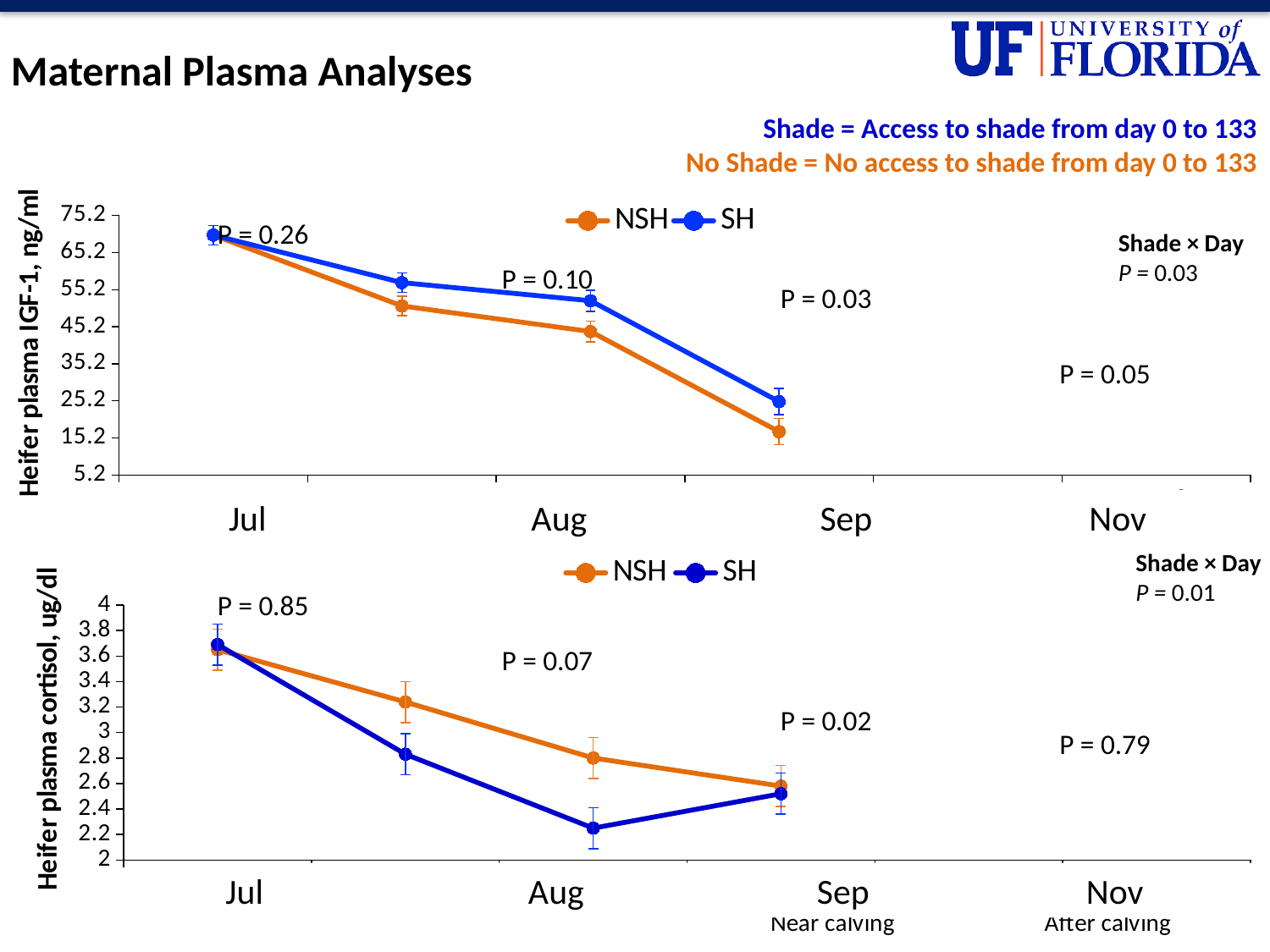
In the top chart (Heifer plasma IGF-1), is the value for NSH at Sep greater or less than 25.2? less In the bottom chart (Heifer plasma cortisol), do the values for NSH rise or fall from Jul to Sep? fall How many data points does the SH series have in the top chart (Heifer plasma IGF-1)? 4 What are the two legend entries in the top chart (Heifer plasma IGF-1)? NSH and SH How many series does the legend of the bottom chart (Heifer plasma cortisol) list? 2 In the top chart (Heifer plasma IGF-1), do the values for NSH rise or fall from Jul to Sep? fall In the top chart (Heifer plasma IGF-1), which series has the higher value at Sep, NSH or SH? SH In the bottom chart (Heifer plasma cortisol), is the value for NSH at Aug greater or less than 2.6? greater In the top chart (Heifer plasma IGF-1), is the value for SH at Jul greater or less than 65.2? greater In the bottom chart (Heifer plasma cortisol), which series has the higher value at Aug, NSH or SH? NSH What kind of chart is the top chart (Heifer plasma IGF-1)? line chart